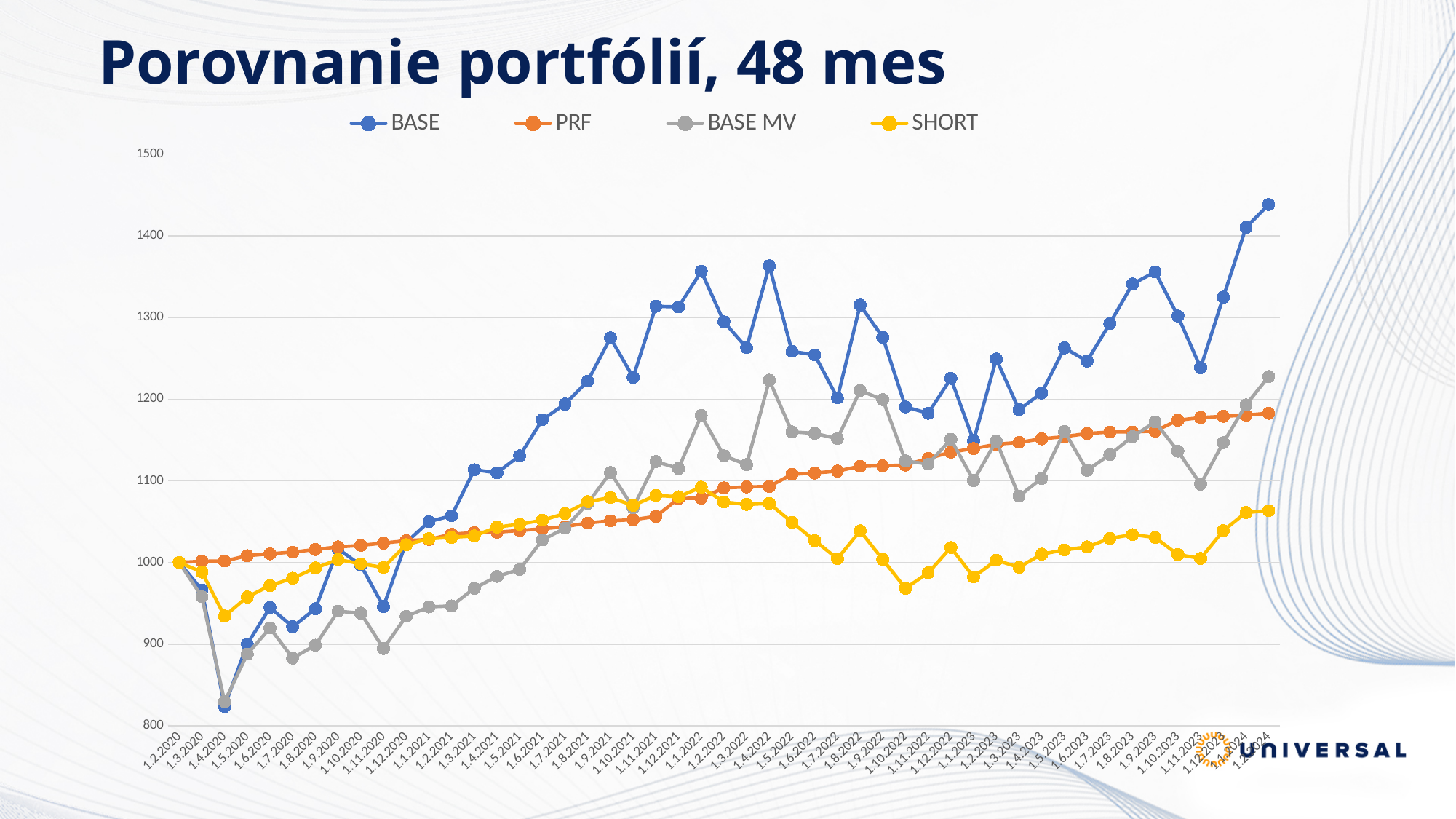
Does the PRF series generally rise or fall from 1.2.2020 to 1.2.2024? rise Is the value for BASE at 1.2.2024 greater or less than 1400? greater Which series has the lowest value at 1.2.2024? SHORT What is the value of the BASE series at 1.2.2020? 1000 What type of chart is shown on the slide? line chart Which series has the highest value at 1.2.2024? BASE How many series does the legend list? 4 At 1.2.2024, which is larger: the value for PRF or the value for BASE MV? BASE MV What is the title of the chart? Porovnanie portfólií, 48 mes Is the value for BASE at 1.4.2020 greater or less than 900? less What colour is the SHORT series line? yellow Is the value for SHORT at 1.2.2024 greater or less than 1100? less